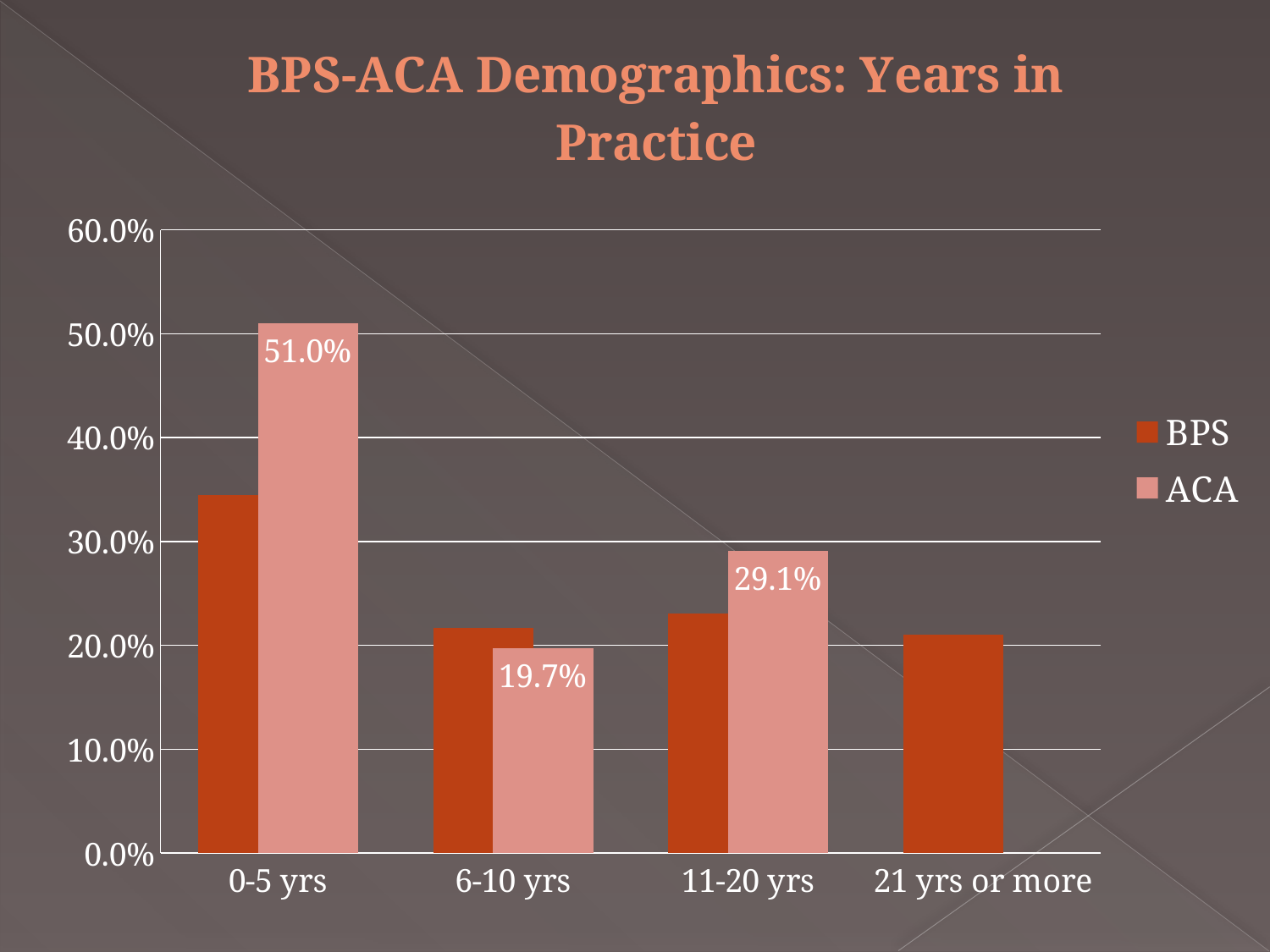
Is the BPS value for 0-5 yrs greater or less than 30.0%? greater Which category has the highest BPS value? 0-5 yrs Which category has the highest ACA value? 0-5 yrs For 0-5 yrs, which series has the larger value, BPS or ACA? ACA For 6-10 yrs, which series has the larger value, BPS or ACA? BPS What is the ACA value for 0-5 yrs? 51.0% What is the difference between the ACA values for 0-5 yrs and 11-20 yrs? 21.9% What is the ACA value for 11-20 yrs? 29.1% What is the ACA value for 6-10 yrs? 19.7% How many series does the legend list? 2 Among the ACA bars shown, which category has the lowest value? 6-10 yrs How many categories are shown on the x axis? 4